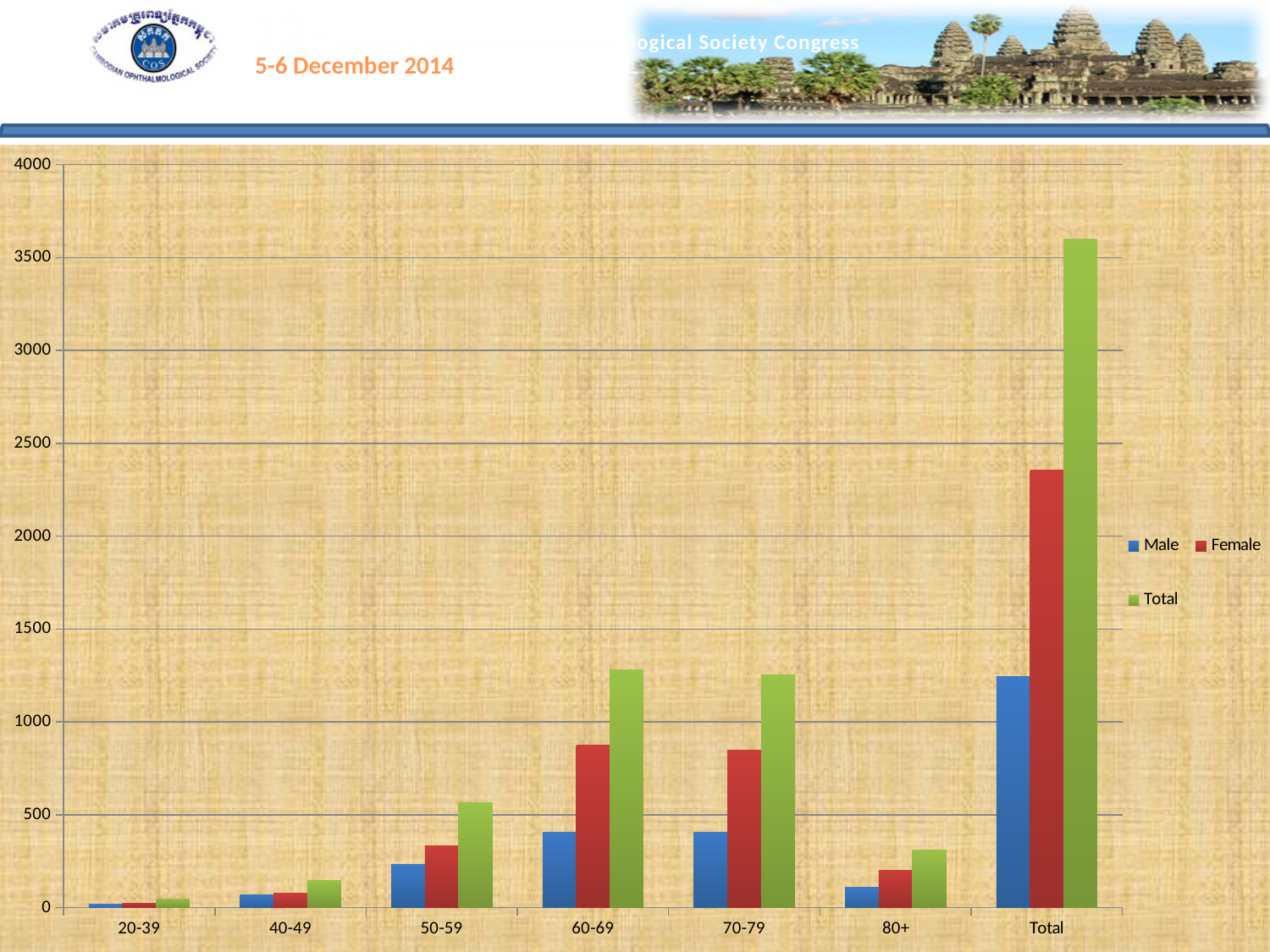
What kind of chart is shown on the slide? bar chart Which series are listed in the legend? Male, Female, Total Is the Male value for the Total category greater or less than 1000? greater How many series does the legend list? 3 Is the Total value for 80+ greater or less than 500? less Which is larger, the Total bar for 50-59 or the Total bar for 80+? 50-59 Among the age groups (excluding the Total category), which has the highest Total bar? 60-69 Is the Female value for the Total category greater or less than 2500? less In the Total category, which is larger, the Male bar or the Female bar? Female Which category has the lowest Total bar? 20-39 How many categories are shown along the x axis? 7